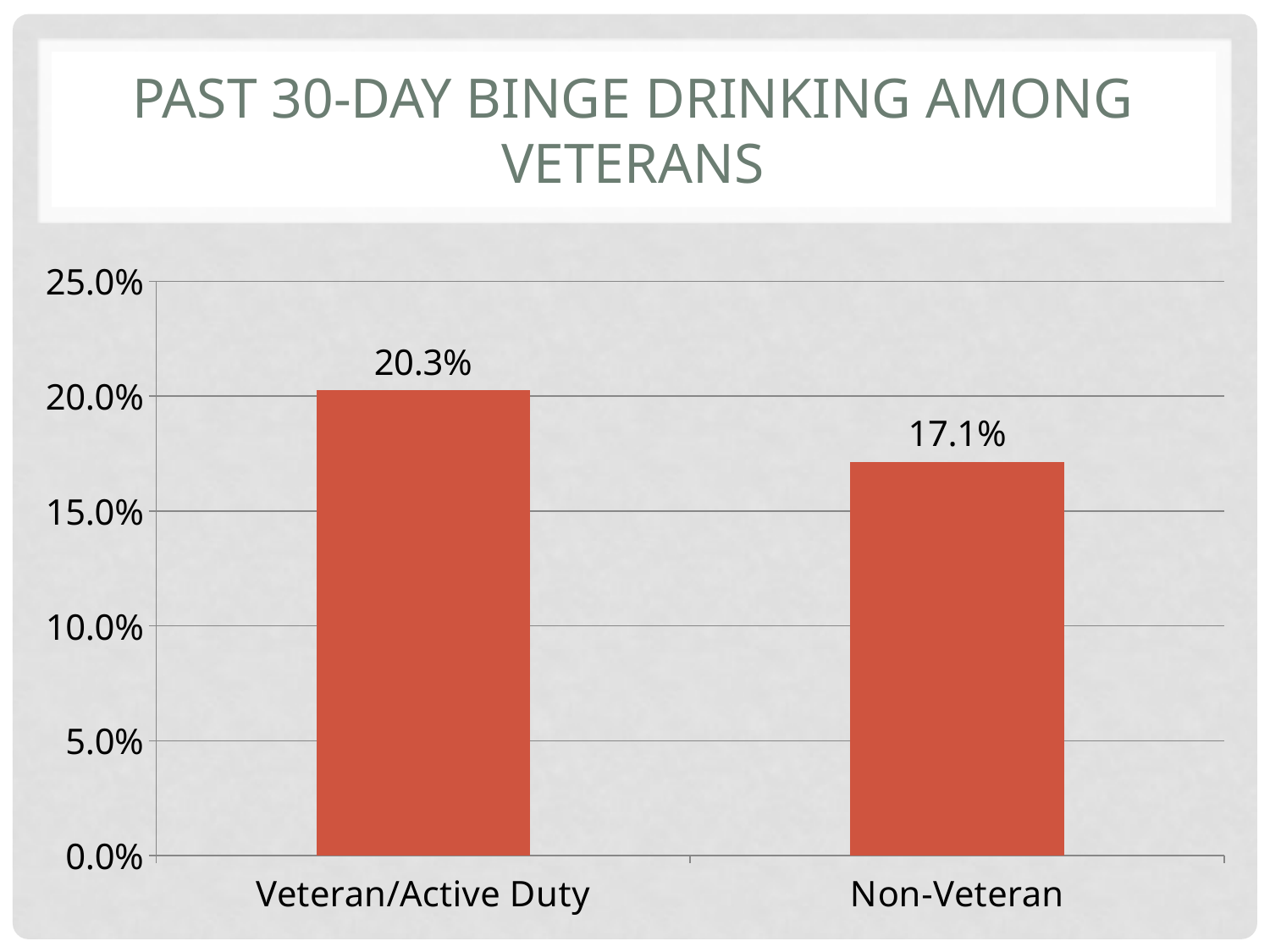
What is the highest value shown on the vertical axis? 25.0% Is the value for Non-Veteran greater or less than 20.0%? less Is the value for Veteran/Active Duty greater or less than 20.0%? greater What is the value for Non-Veteran? 17.1% What is the difference between the Veteran/Active Duty and Non-Veteran values? 3.2% Which category has the lowest value? Non-Veteran Which is larger, the value for Veteran/Active Duty or the value for Non-Veteran? Veteran/Active Duty What is the title of the slide? Past 30-Day Binge Drinking Among Veterans What kind of chart is shown on the slide? bar chart Which category has the highest value? Veteran/Active Duty How many categories are shown on the chart? 2 What is the value for Veteran/Active Duty? 20.3%